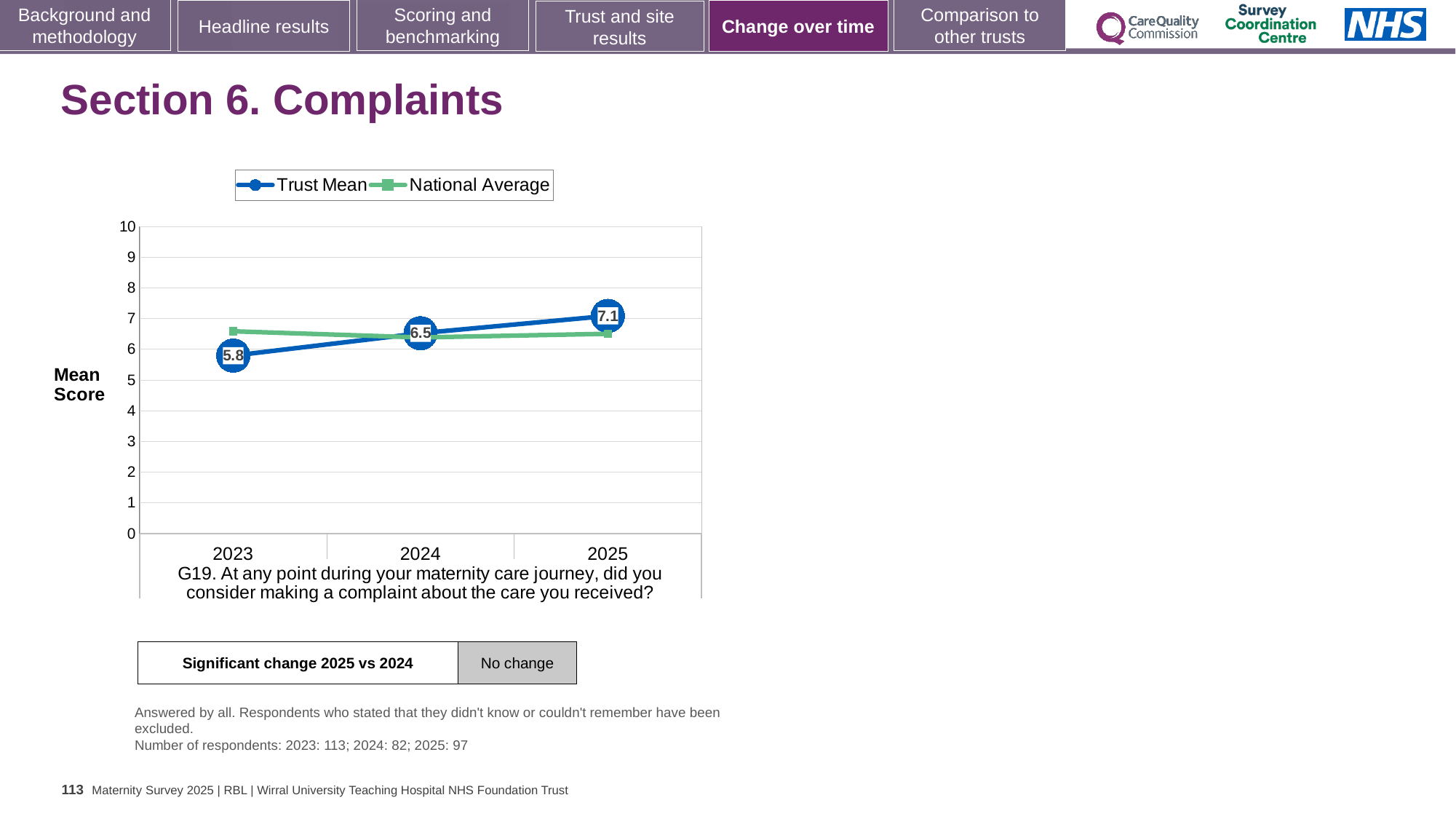
What kind of chart is shown on the slide? Line chart How many series does the legend list? 2 In which year is the Trust Mean highest? 2025 What is the Trust Mean value for 2023? 5.8 What is the Trust Mean value for 2025? 7.1 In which year is the Trust Mean lowest? 2023 Which is larger, the Trust Mean in 2024 or the Trust Mean in 2023? 2024 What is the difference between the Trust Mean in 2025 and in 2023? 1.3 Does the Trust Mean rise or fall from 2023 to 2025? Rise Is the National Average value for 2025 greater or less than 7? less How many years are plotted on the x axis? 3 Is the National Average value for 2023 greater or less than 6? greater